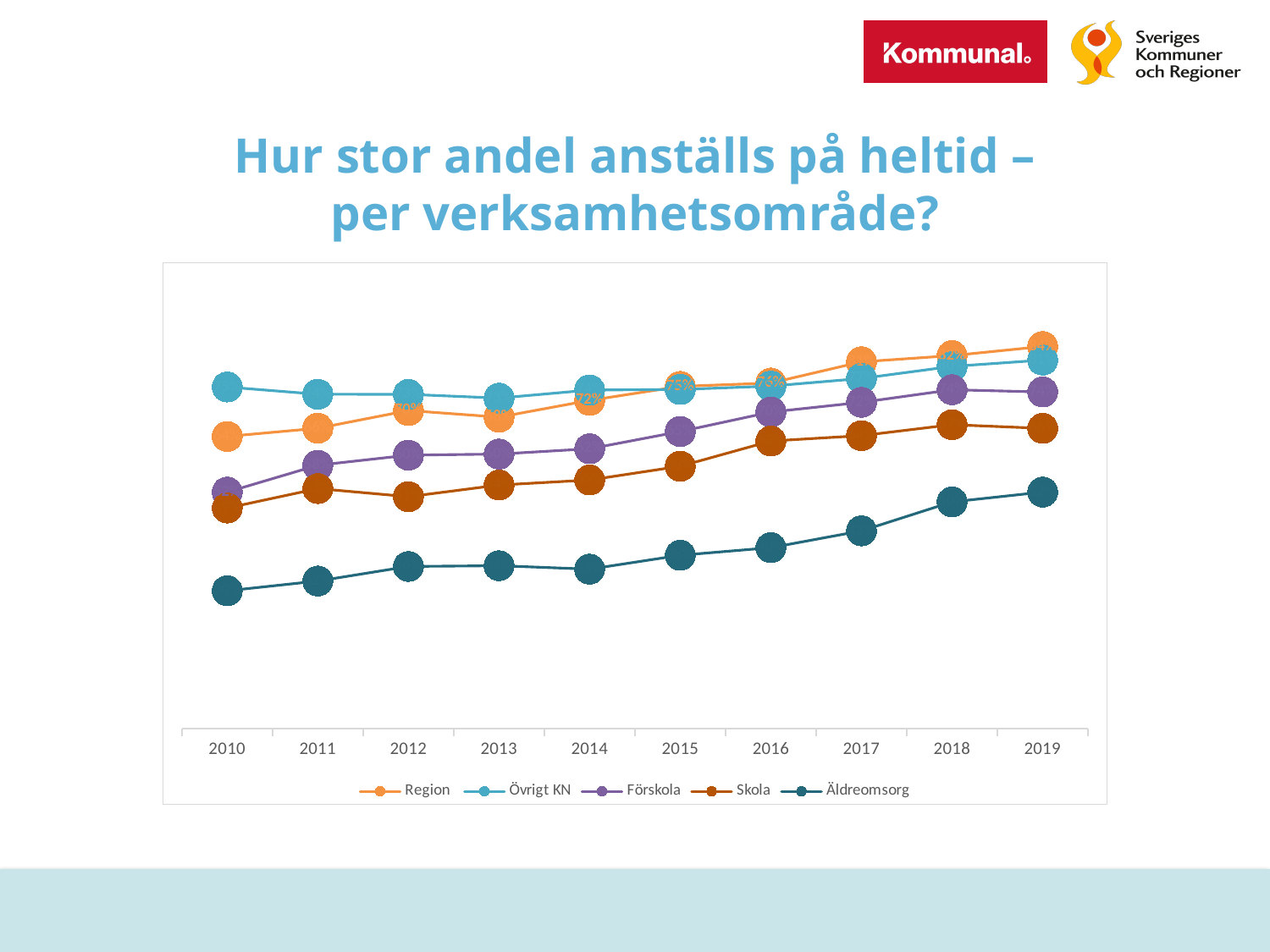
Which series has the highest value in 2010? Övrigt KN Does the Region series generally rise or fall from 2010 to 2019? Rise What kind of chart is shown on the slide? Line chart What is the title of the slide? Hur stor andel anställs på heltid – per verksamhetsområde? How many years are shown along the x axis? 10 Which series has the lowest values across all years? Äldreomsorg In 2019, which is higher: Förskola or Skola? Förskola Which series has the highest value in 2019? Region How many series does the legend list? 5 In 2010, which is higher: Region or Förskola? Region Does the Äldreomsorg series rise or fall from 2010 to 2019? Rise Which series is shown in orange? Region